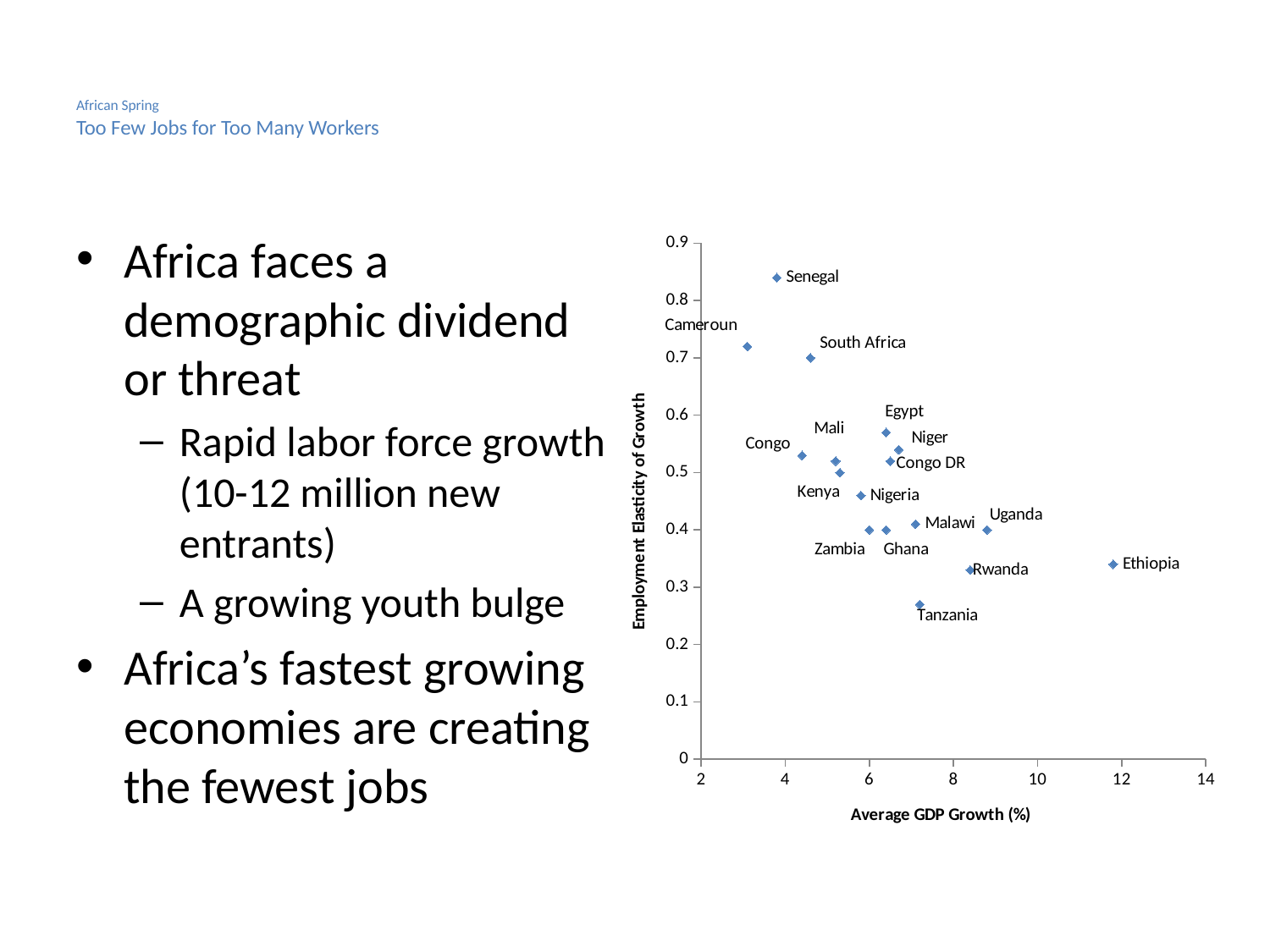
Which country has the lowest average GDP growth? Cameroun Is the average GDP growth for Ethiopia greater or less than 10? greater Which has a higher average GDP growth, Uganda or Congo? Uganda What is the title of the x axis? Average GDP Growth (%) Which has a higher employment elasticity of growth, South Africa or Nigeria? South Africa Is the employment elasticity of growth for Tanzania greater or less than 0.3? less What kind of chart is shown on the slide? Scatter chart Which country has the lowest employment elasticity of growth? Tanzania Which country has the highest average GDP growth? Ethiopia Which country has the highest employment elasticity of growth? Senegal Is the employment elasticity of growth for Senegal greater or less than 0.8? greater As average GDP growth increases along the x axis, does employment elasticity of growth generally rise or fall? Fall